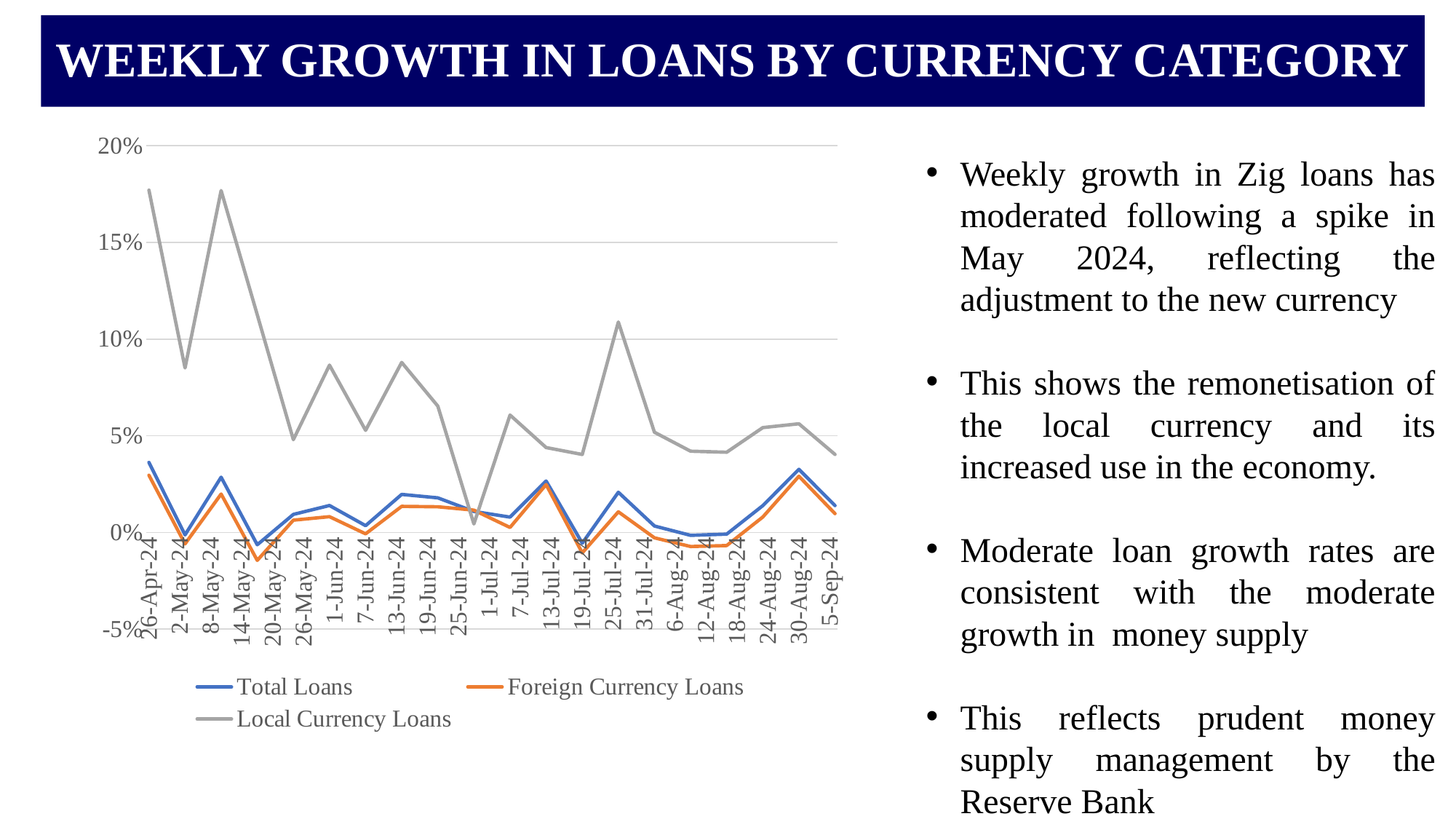
On which date is the Local Currency Loans series at its lowest? 25-Jun-24 What kind of chart is shown on the slide? line chart How many series does the chart legend list? 3 Is the value for Local Currency Loans on 25-Jul-24 greater or less than 10%? greater On 26-Apr-24, which series has the larger value: Local Currency Loans or Total Loans? Local Currency Loans Is the value for Foreign Currency Loans on 14-May-24 greater or less than 0%? less Is the value for Local Currency Loans on 26-Apr-24 greater or less than 15%? greater Does the Local Currency Loans series overall rise or fall from 26-Apr-24 to 5-Sep-24? fall What is the title of the slide containing the chart? WEEKLY GROWTH IN LOANS BY CURRENCY CATEGORY